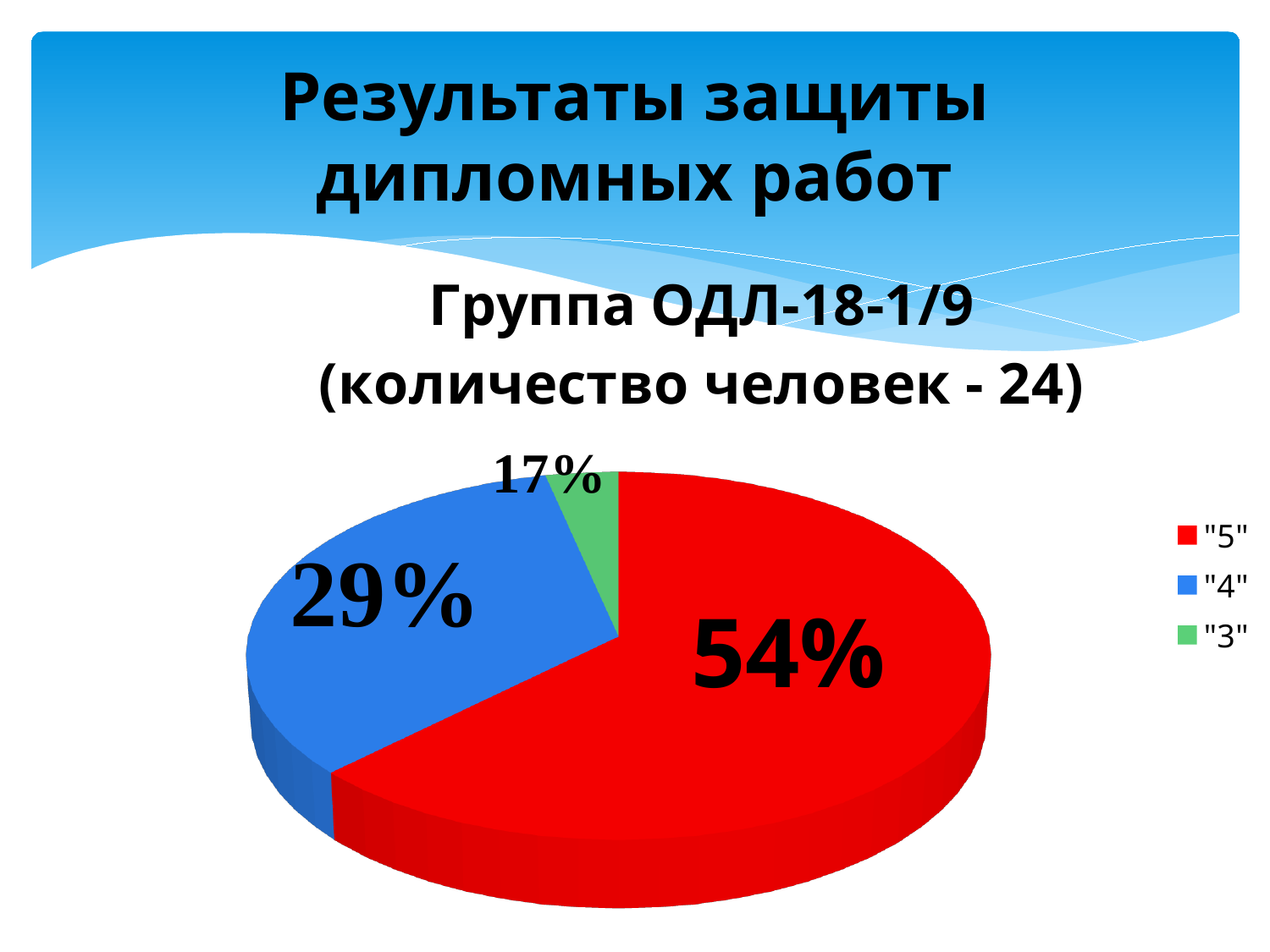
Which category has the largest slice of the pie? "5" What share of the pie does the "4" slice represent? 29% What colour is the "4" slice in the pie chart? Blue Which category has the smallest slice of the pie? "3" What share of the pie does the "5" slice represent? 54% What kind of chart is shown on the slide? Pie chart How many slices does the pie chart have? 3 What is the difference in percentage points between the "4" slice and the "3" slice? 12 Which is larger, the "4" slice or the "3" slice? "4" What share of the pie does the "3" slice represent? 17% What is the title of the chart? Группа ОДЛ-18-1/9 (количество человек - 24) What is the difference in percentage points between the "5" slice and the "4" slice? 25